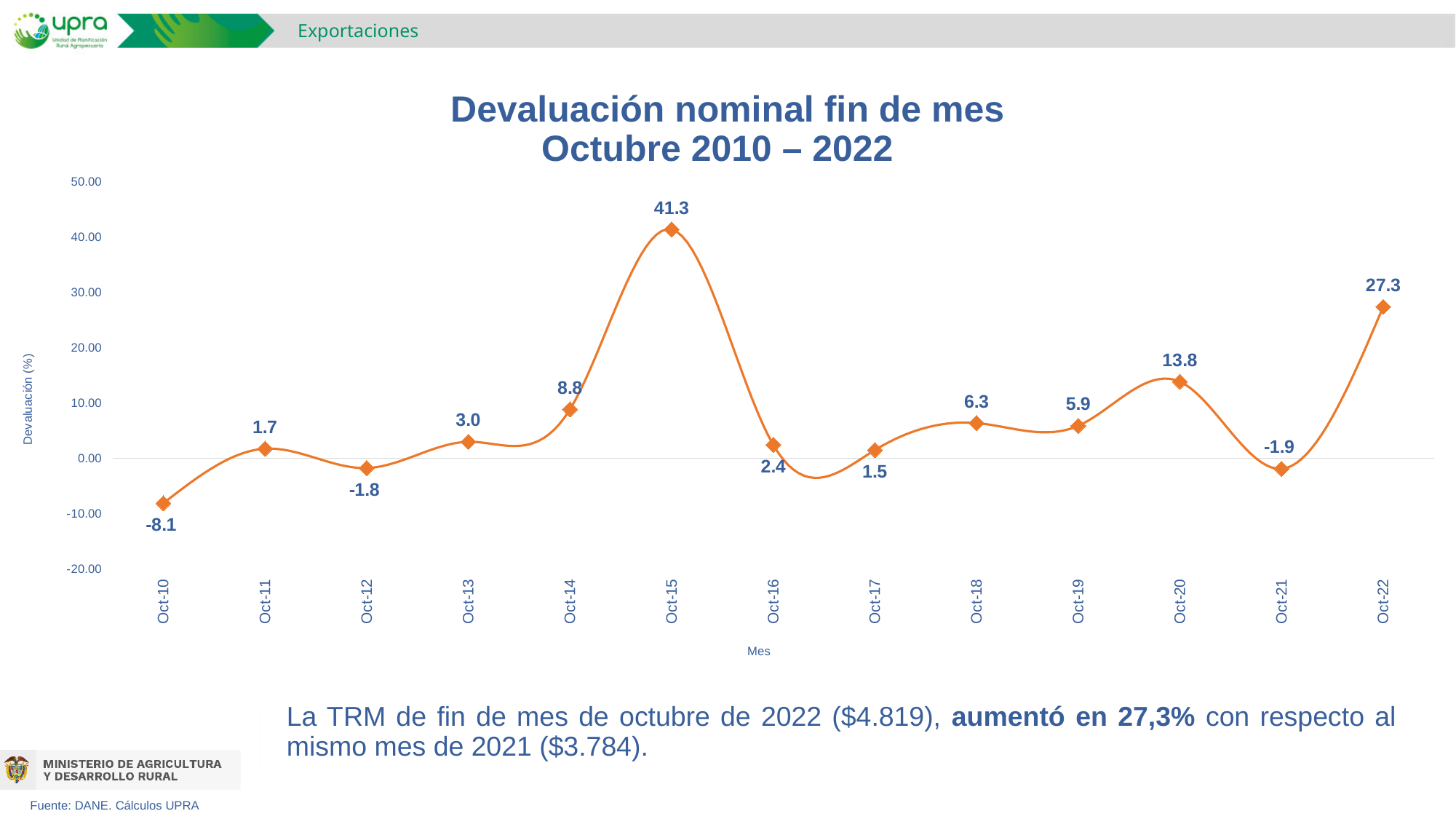
Which is larger, the value for Oct-18 or the value for Oct-19? Oct-18 How many data points are plotted on the chart? 13 What is the value for Oct-10? -8.1 Which month has the highest value? Oct-15 What is the value for Oct-15? 41.3 What is the value for Oct-20? 13.8 What is the difference between the values for Oct-15 and Oct-22? 14.0 Is the value for Oct-15 greater or less than 40.00? greater Which month has the lowest value? Oct-10 What is the title of the chart? Devaluación nominal fin de mes Octubre 2010 – 2022 What is the value for Oct-22? 27.3 What kind of chart is shown? line chart